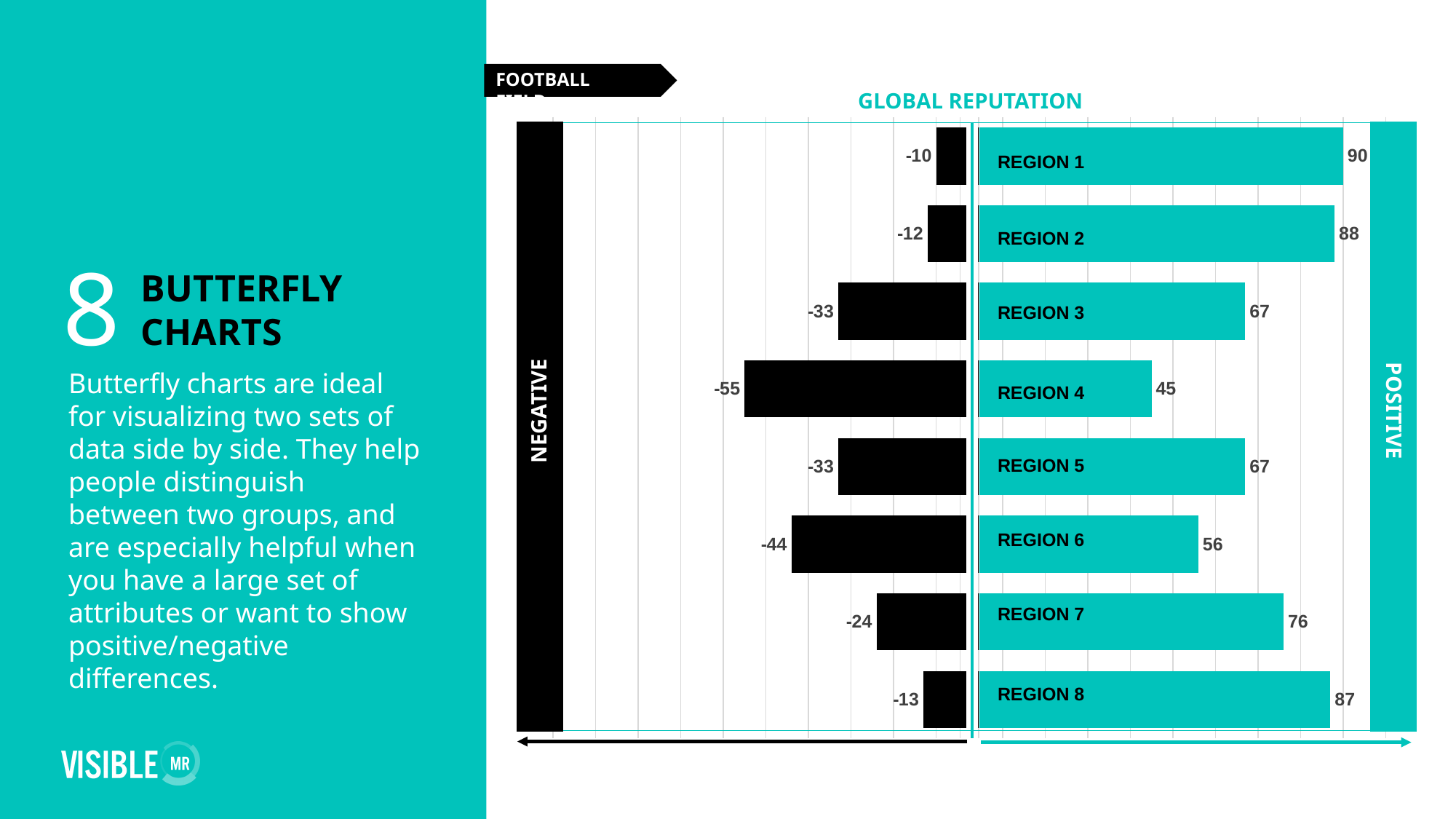
What is the negative value for Region 7 in the Global Reputation chart? -24 What is the positive value for Region 1 in the Global Reputation chart? 90 What kind of chart is the Global Reputation chart? Butterfly chart (bar chart) What is the positive value for Region 6 in the Global Reputation chart? 56 Which region has the highest positive value in the Global Reputation chart? Region 1 Which has a larger positive value in the Global Reputation chart, Region 7 or Region 6? Region 7 How many regions are shown in the Global Reputation chart? 8 What are the two sides of the Global Reputation chart labelled? Negative and Positive Which region has the largest negative bar (most negative value) in the Global Reputation chart? Region 4 Which region has the lowest positive value in the Global Reputation chart? Region 4 What is the negative value for Region 4 in the Global Reputation chart? -55 What is the difference between the positive values of Region 1 and Region 4 in the Global Reputation chart? 45